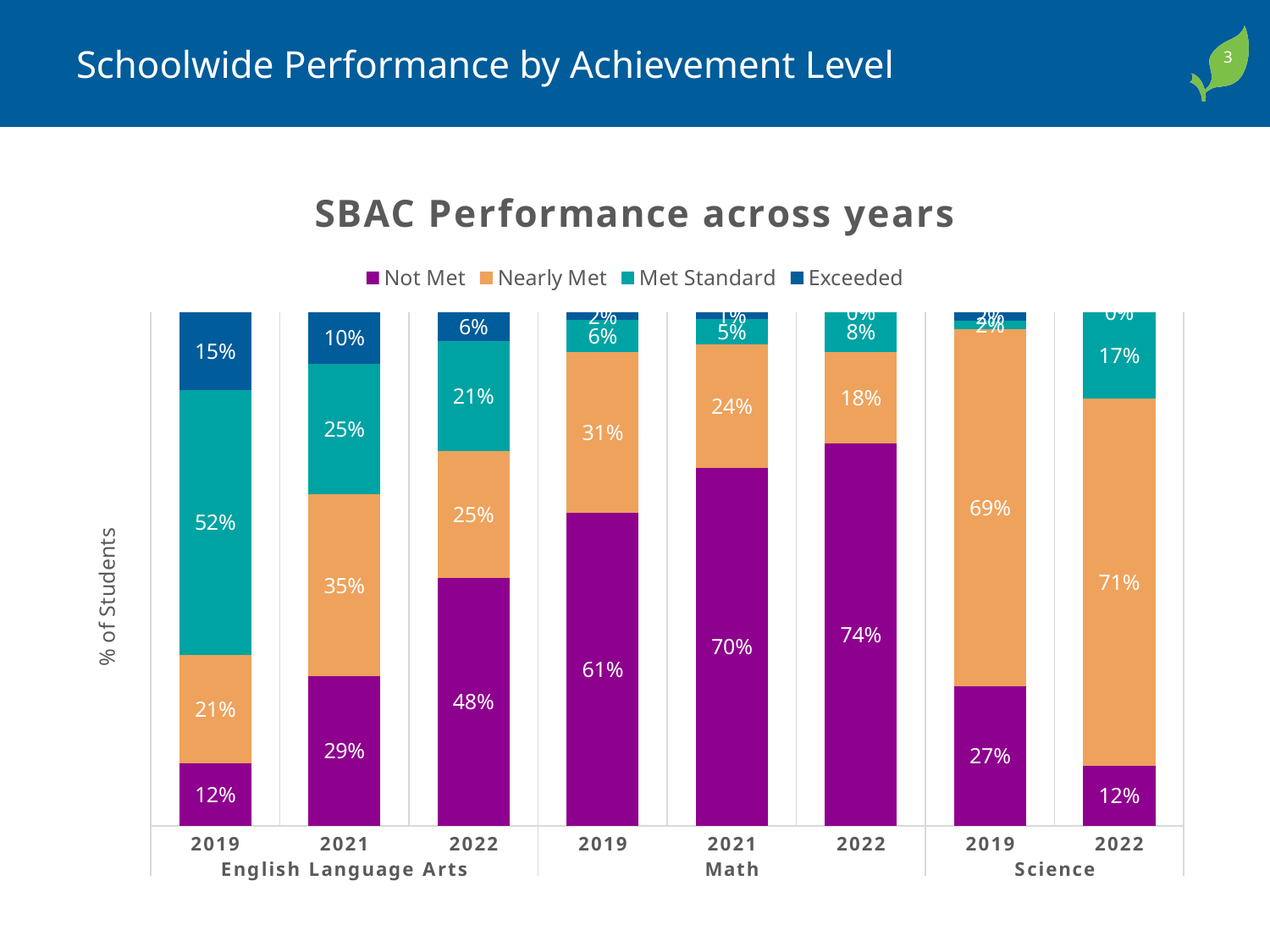
What is the title of the chart? SBAC Performance across years What type of chart is shown on the slide? stacked bar chart Which bar has the lowest Not Met percentage? English Language Arts 2019 and Science 2022 (both 12%) What is the Nearly Met percentage for Science in 2022? 71% Which bar has the highest Not Met percentage? Math 2022 What is the Met Standard percentage for English Language Arts in 2021? 25% Which is larger: the Met Standard percentage for English Language Arts in 2019 or for English Language Arts in 2022? English Language Arts 2019 What is the Not Met percentage for English Language Arts in 2019? 12% How many stacked bars are plotted in the chart? 8 What is the difference between the Not Met percentage for Math in 2022 and Math in 2019? 13% How does the Not Met percentage for English Language Arts change from 2019 to 2022? It rises How many series does the legend list? 4